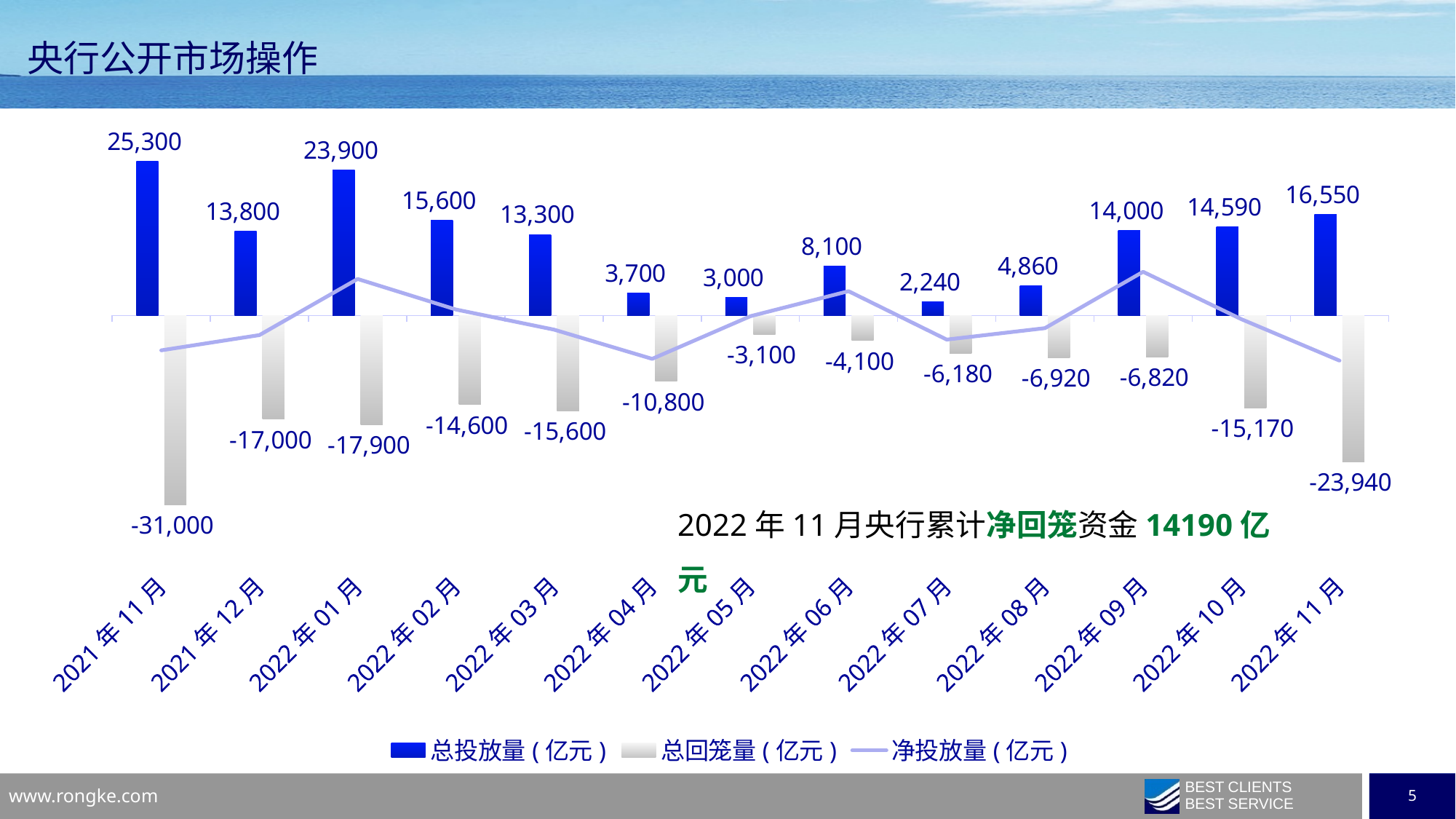
Which is larger, the 总投放量 (亿元) for 2022年02月 or for 2022年03月? 2022年02月 What is the 总投放量 (亿元) value for 2022年01月? 23,900 Which month has the lowest (most negative) 总回笼量 (亿元)? 2021年11月 How many series does the legend list? 3 How many months are shown on the x axis? 13 What is the 总回笼量 (亿元) value for 2022年11月? -23,940 What kind of chart is shown on the slide? Combination bar and line chart What is the title of the slide? 央行公开市场操作 Which month has the highest 总投放量 (亿元)? 2021年11月 Which month has the lowest 总投放量 (亿元)? 2022年07月 What is the difference between the 总投放量 (亿元) for 2022年11月 and 2022年10月? 1,960 What is the 总回笼量 (亿元) value for 2022年05月? -3,100